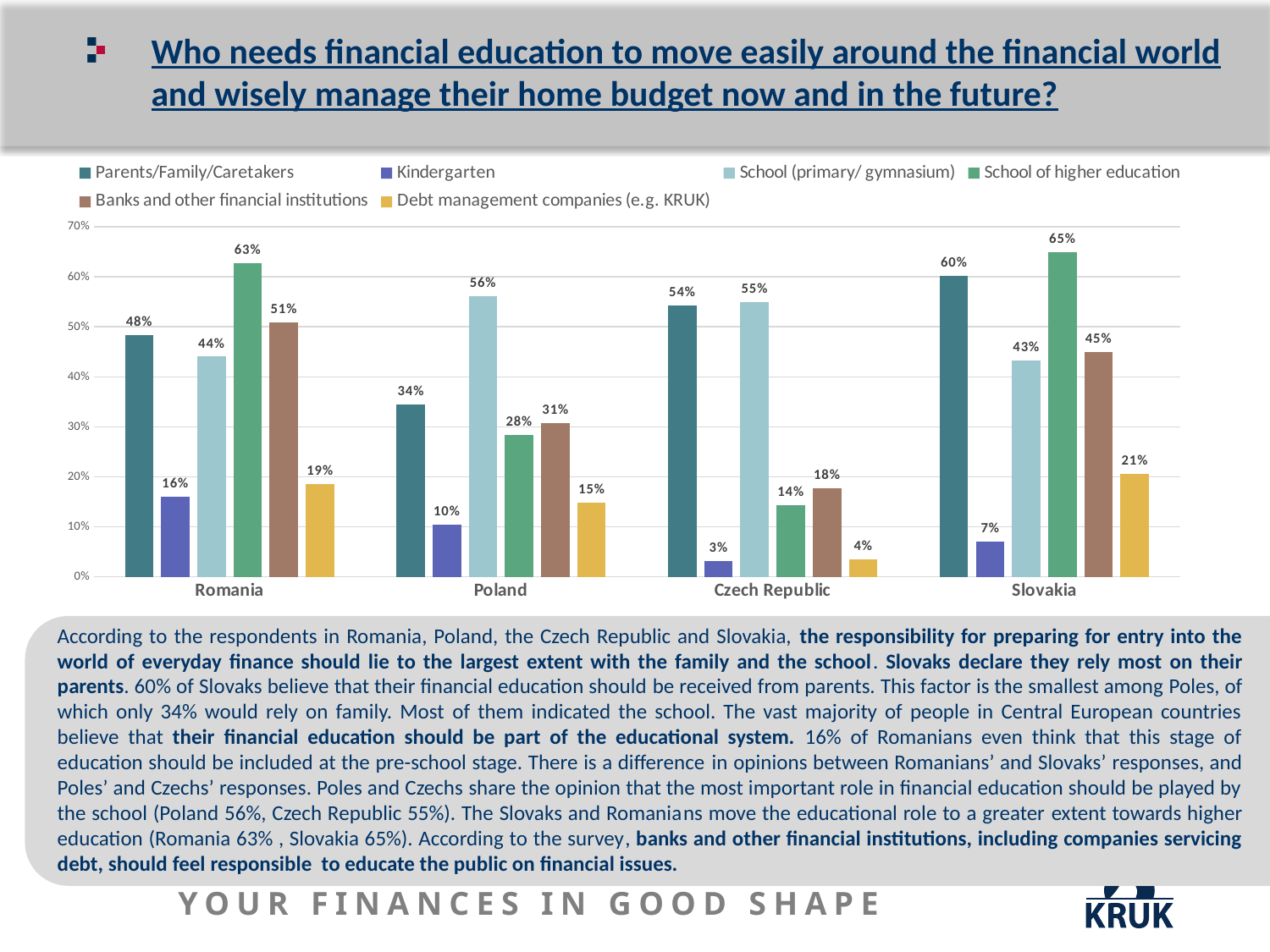
What is the difference between the Parents/Family/Caretakers values for Slovakia and Poland? 26 percentage points What type of chart is shown on the slide? Bar chart What is the value for School (primary/ gymnasium) in Poland? 56% What is the difference between the School of higher education values for Slovakia and the Czech Republic? 51 percentage points How many countries are shown on the x axis? 4 How many series does the legend list? 6 Which is larger in Romania: Banks and other financial institutions or School (primary/ gymnasium)? Banks and other financial institutions Which country has the lowest value for Kindergarten? Czech Republic What percentage of respondents in Slovakia chose Parents/Family/Caretakers? 60% What is the value for Debt management companies (e.g. KRUK) in the Czech Republic? 4% What is the value for Kindergarten in Romania? 16% Which country has the highest value for School of higher education? Slovakia